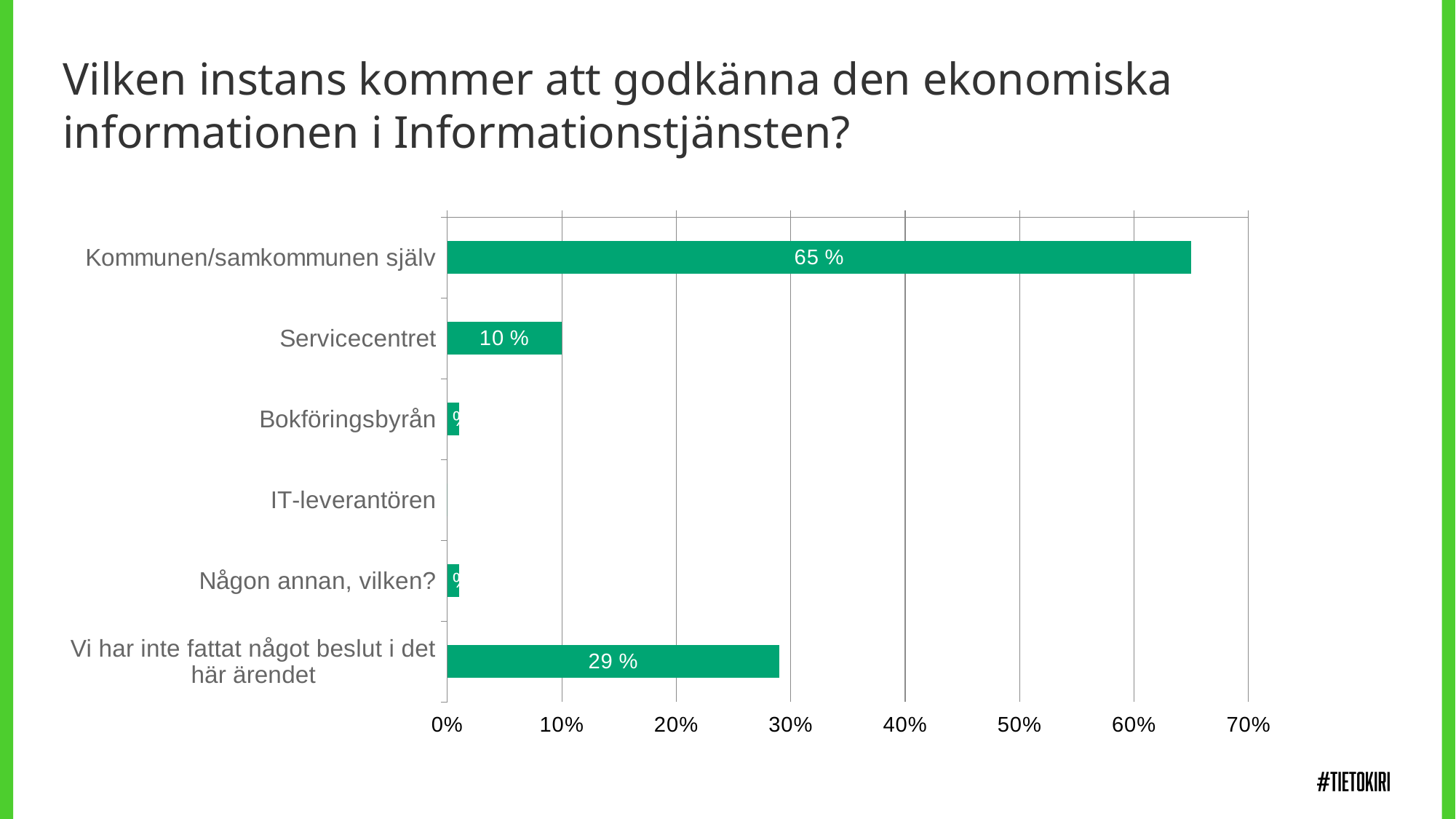
What kind of chart is shown on the slide? bar chart What is the title of the slide? Vilken instans kommer att godkänna den ekonomiska informationen i Informationstjänsten? What is the value for "Vi har inte fattat något beslut i det här ärendet"? 29 % What is the value for Servicecentret? 10 % How many categories are shown in the chart? 6 Which is larger: the value for Servicecentret or the value for "Vi har inte fattat något beslut i det här ärendet"? Vi har inte fattat något beslut i det här ärendet What is the value for Kommunen/samkommunen själv? 65 % What is the difference between the values for Kommunen/samkommunen själv and "Vi har inte fattat något beslut i det här ärendet"? 36 % Which category has the highest value? Kommunen/samkommunen själv Is the value for Bokföringsbyrån greater or less than 10%? less Which category has the lowest value? IT-leverantören What is the difference between the values for "Vi har inte fattat något beslut i det här ärendet" and Servicecentret? 19 %